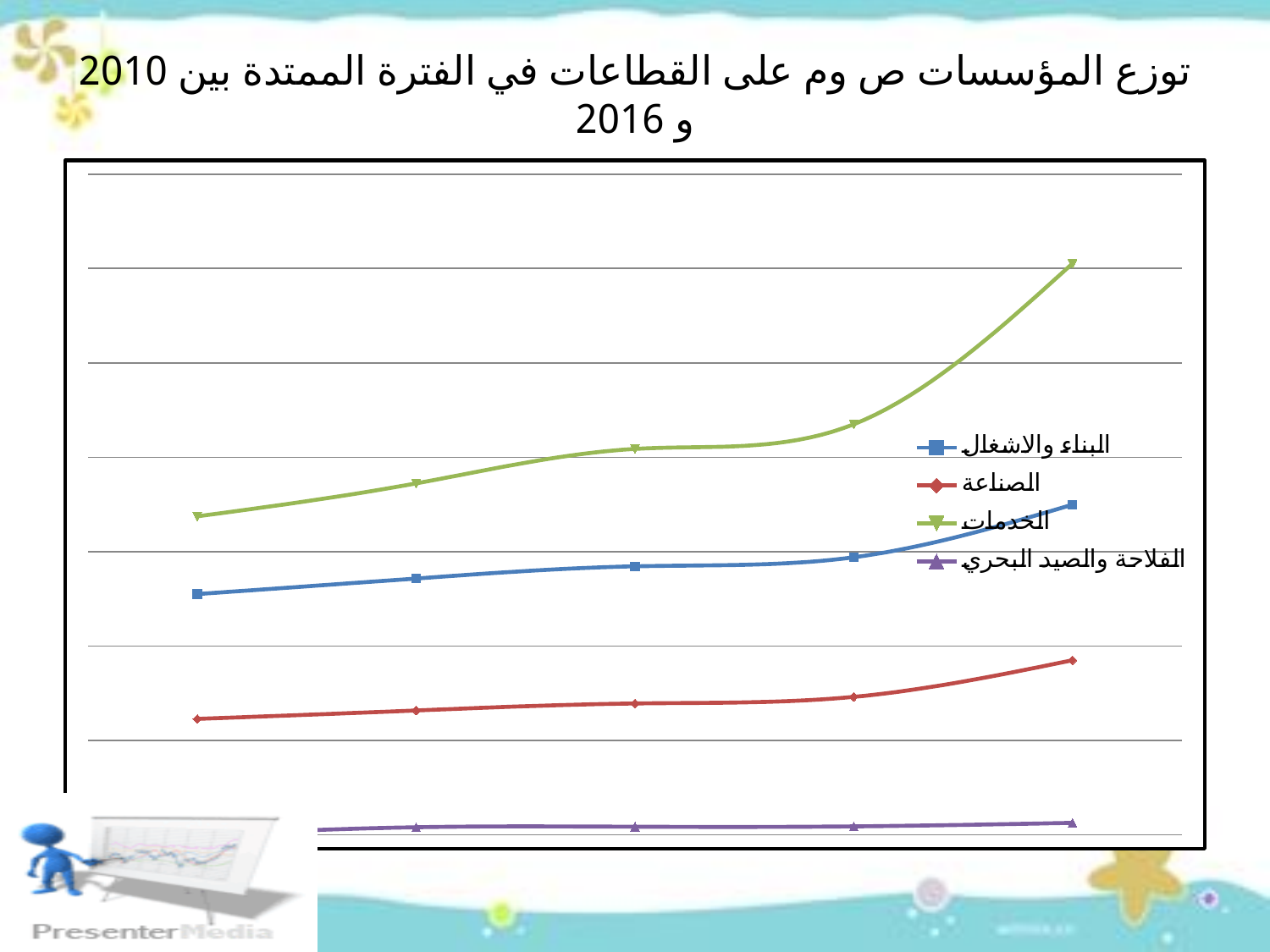
How many data points are plotted on the الخدمات line? 5 What kind of chart is shown on the slide? line chart How many series does the legend list? 4 Which series is drawn with a green line? الخدمات Which series shows the steepest increase at the end of the period? الخدمات Does the الصناعة series rise or fall from left to right? rise Which series is higher at the first point, الخدمات or البناء والاشغال? الخدمات Does the الخدمات series rise or fall from left to right? rise What colour is the line for الصناعة? red Which series is higher at the last point, البناء والاشغال or الصناعة? البناء والاشغال Which series has the lowest values across the chart? الفلاحة والصيد البحري Which series has the highest values across the chart? الخدمات